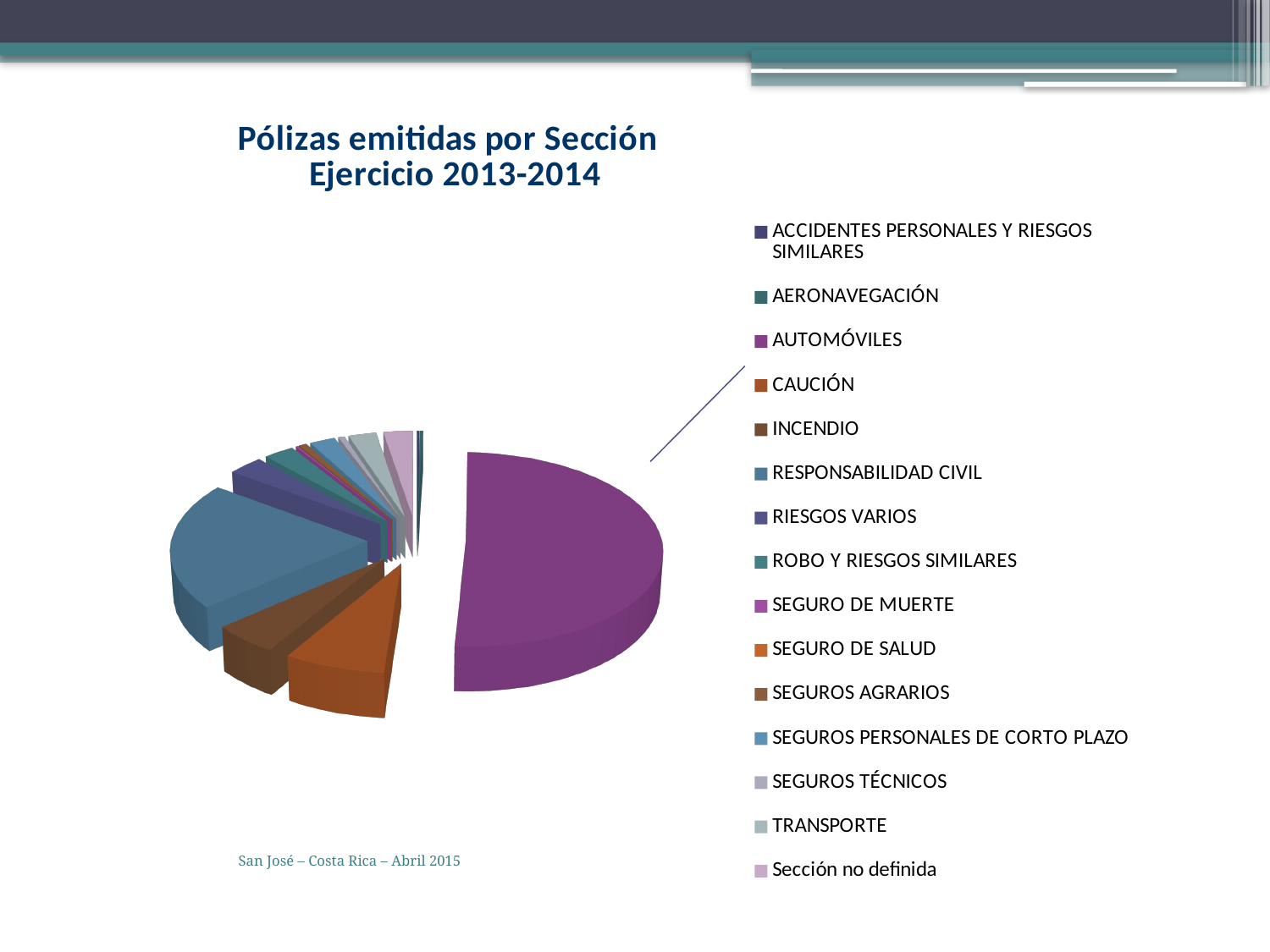
What is the title of the chart? Pólizas emitidas por Sección Ejercicio 2013-2014 Which category is listed first in the legend? ACCIDENTES PERSONALES Y RIESGOS SIMILARES Which slice is larger, AUTOMÓVILES or CAUCIÓN? AUTOMÓVILES What kind of chart is shown on the slide? pie chart Which category has the largest slice of the pie? AUTOMÓVILES Which slice is larger, RESPONSABILIDAD CIVIL or INCENDIO? RESPONSABILIDAD CIVIL Which slice is larger, AUTOMÓVILES or RESPONSABILIDAD CIVIL? AUTOMÓVILES How many categories does the legend of the pie chart list? 15